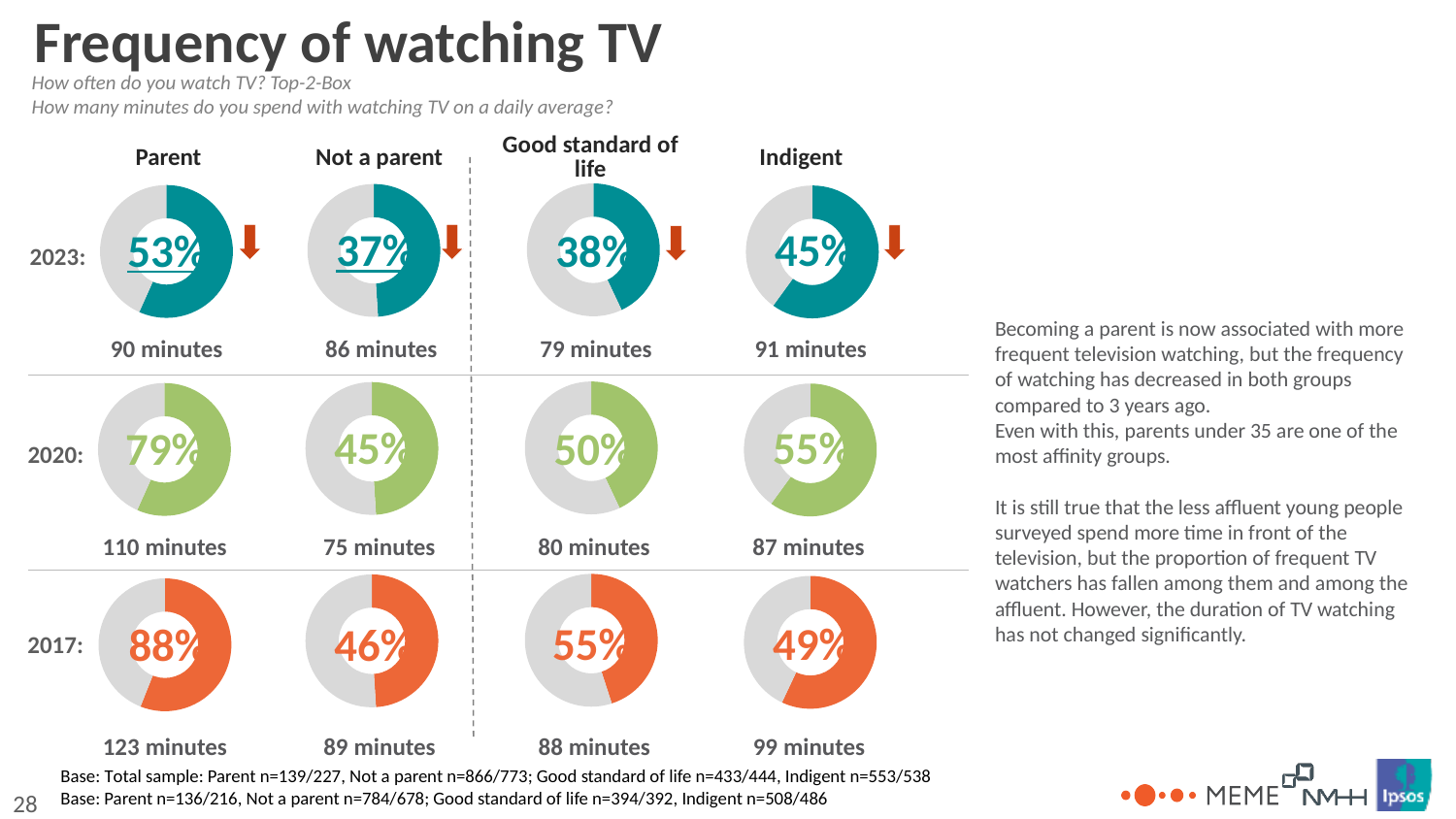
In the 2023 row, what percentage is shown in the Parent donut chart? 53% In the 2023 row, how many minutes are shown under the Good standard of life donut chart? 79 minutes What is the difference between the Parent percentage in 2017 and the Parent percentage in 2023? 35 percentage points What colour are the donut charts in the 2020 row? Green Across the 2023 row of donut charts, which group has the highest percentage? Parent Across the 2020 row of donut charts, which group has the lowest percentage? Not a parent In the 2020 row, what percentage is shown in the Indigent donut chart? 55% Looking at the Parent column from 2017 to 2023, do the percentages rise or fall over time? Fall In the 2017 row, which is larger: the Good standard of life percentage or the Indigent percentage? Good standard of life How many donut charts are shown on the slide in total? 12 What type of chart is used to display the percentages on this slide? Donut (pie) chart In the 2017 row, how many minutes are shown under the Parent donut chart? 123 minutes